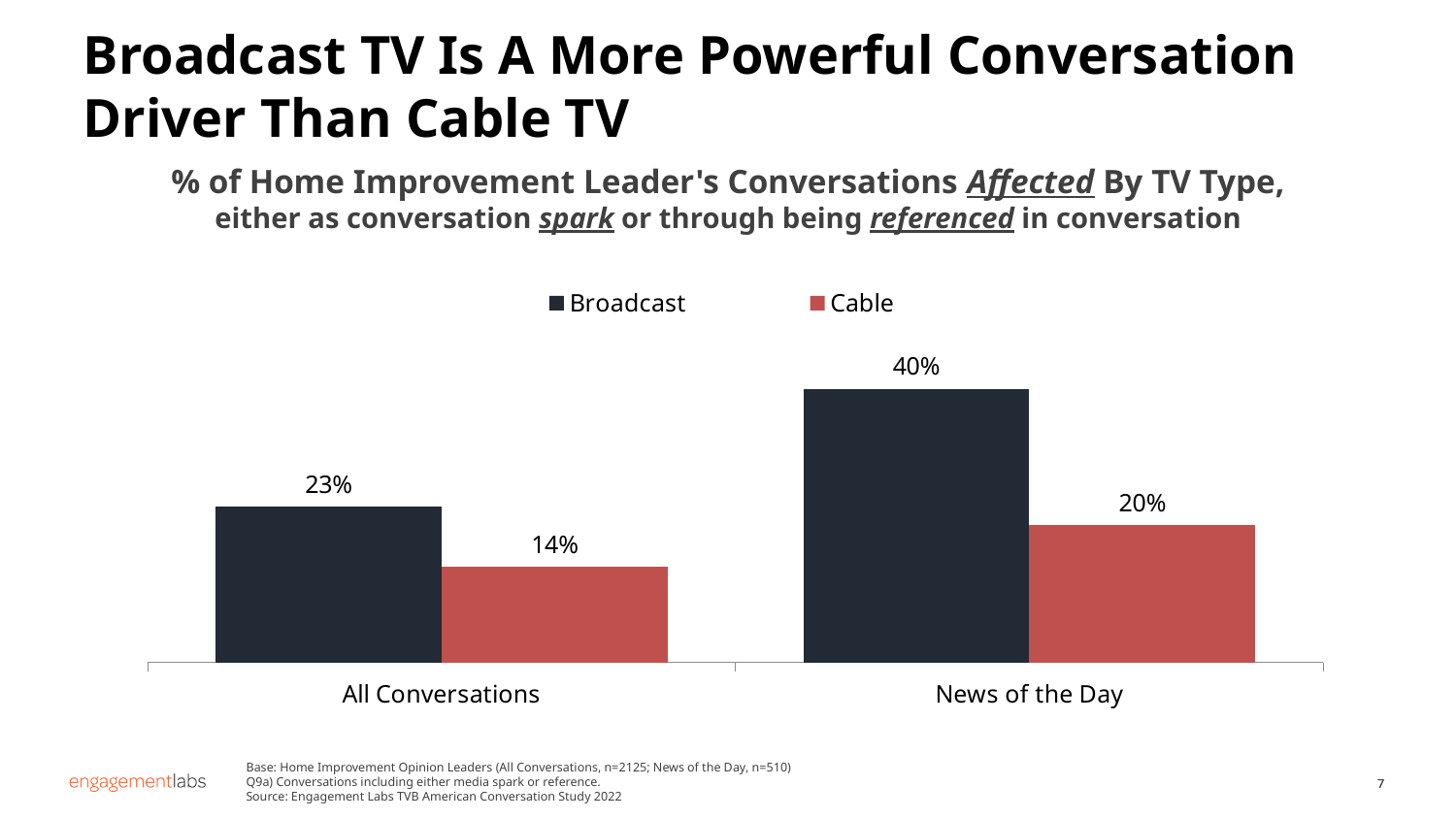
What is the difference between the Broadcast and Cable values for All Conversations? 9% Which is larger for All Conversations, Broadcast or Cable? Broadcast What is the Broadcast value for News of the Day? 40% Which category has the lowest Cable value? All Conversations What kind of chart is shown on the slide? Bar chart How many categories are shown on the x axis? 2 Which category has the highest Broadcast value? News of the Day How many series does the legend list? 2 What is the Cable value for News of the Day? 20% What is the Broadcast value for All Conversations? 23% What is the difference between the Broadcast and Cable values for News of the Day? 20% What is the Cable value for All Conversations? 14%